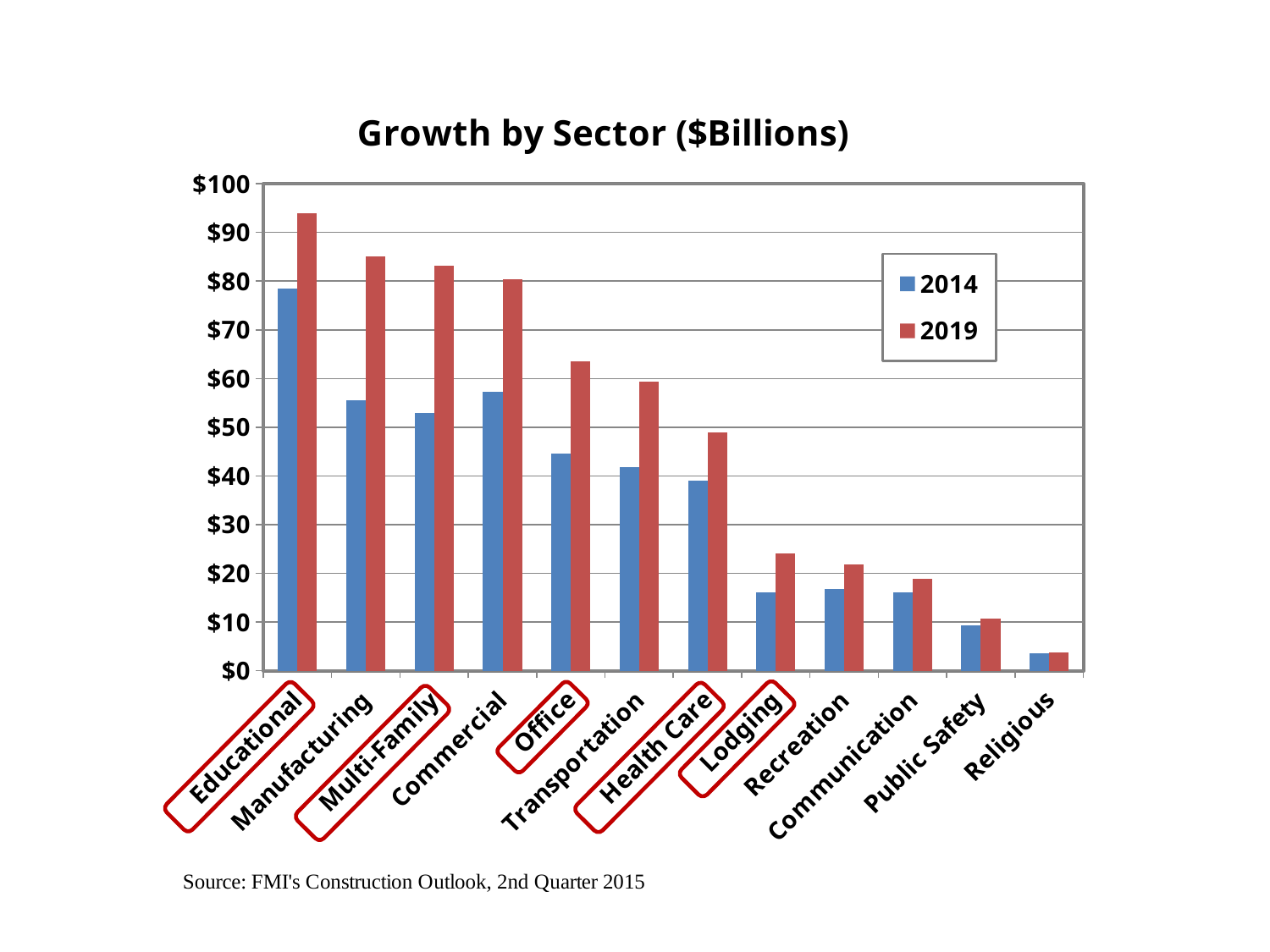
Which sector has the highest 2019 value? Educational Is the 2019 value for Manufacturing greater or less than $80? greater Is the 2014 value for Educational greater or less than $70? greater How many series does the legend list? 2 What is the title of the chart? Growth by Sector ($Billions) How many sectors are shown on the x axis? 12 Which is larger, the 2019 value for Office or the 2019 value for Transportation? Office Is the 2019 value for Lodging greater or less than $20? greater What kind of chart is shown on the slide? Bar chart Which sector has the lowest 2014 value? Religious Do the values generally rise or fall moving from left to right along the x axis? fall